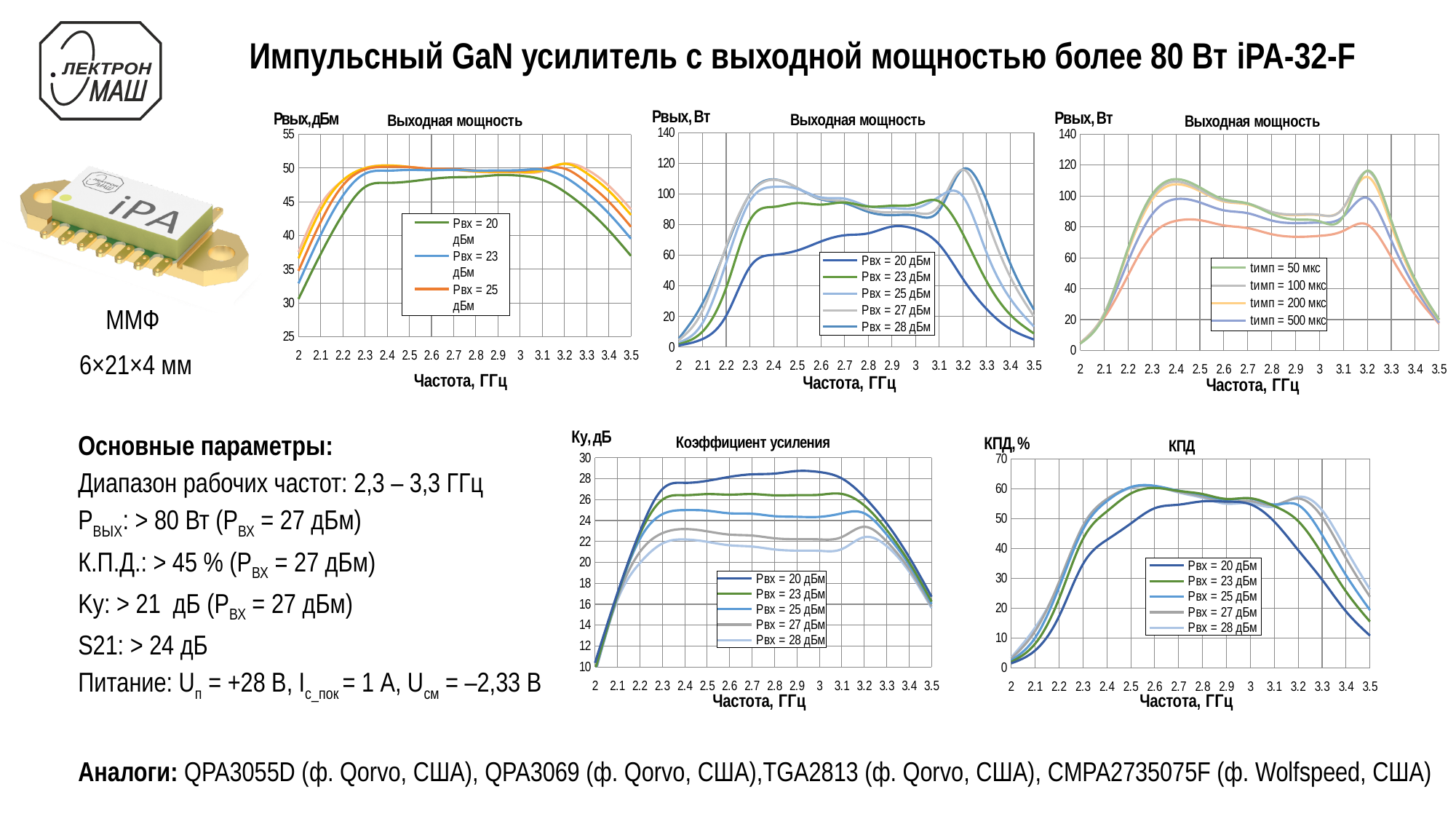
In the 'КПД' chart, is the value for Рвх = 20 дБм at 2.2 ГГц greater or less than 40? less What is the x-axis label of the 'КПД' chart? Частота, ГГц How many series does the legend of the top-left 'Выходная мощность' chart (Рвых, дБм) list? 3 In the 'Коэффициент усиления' chart, is the value for Рвх = 28 дБм at 2.5 ГГц greater or less than 24? less In the 'Коэффициент усиления' chart, is the value for Рвх = 20 дБм at 2.5 ГГц greater or less than 26? greater How many series does the legend of the 'КПД' chart list? 5 In the 'КПД' chart, does the Рвх = 20 дБм series rise or fall between 3.2 and 3.5 ГГц? fall How many series does the legend of the top-right 'Выходная мощность' chart (Рвых, Вт, tимп) list? 4 What kind of chart is the 'Коэффициент усиления' chart? line chart